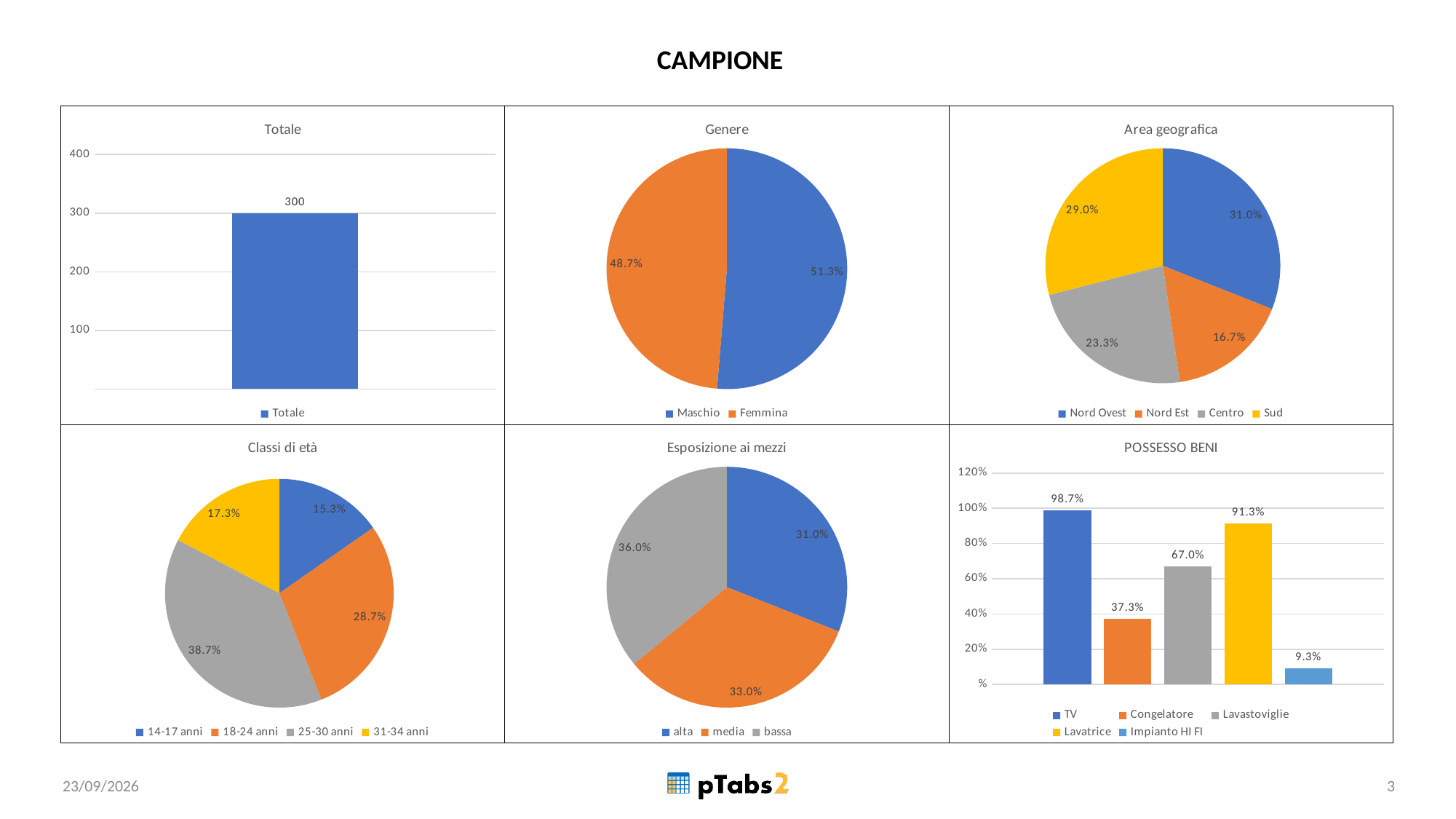
In the 'Classi di età' chart, which age class has the smallest share? 14-17 anni In the 'Totale' chart, what value is shown for Totale? 300 In the 'Esposizione ai mezzi' chart, what is the value for bassa? 36.0% In the 'Genere' chart, which is larger, Maschio or Femmina? Maschio In the 'Genere' chart, what share of the pie is Maschio? 51.3% In the 'Area geografica' chart, what is the value for Nord Est? 16.7% In the 'Area geografica' chart, what is the difference between Sud and Centro? 5.7% In the 'POSSESSO BENI' chart, what is the value for Lavastoviglie? 67.0% In the 'Classi di età' chart, what is the value for 25-30 anni? 38.7% In the 'Esposizione ai mezzi' chart, how many slices does the pie have? 3 In the 'Area geografica' chart, which area has the largest share? Nord Ovest In the 'POSSESSO BENI' chart, what is the difference between TV and Impianto HI FI? 89.4%